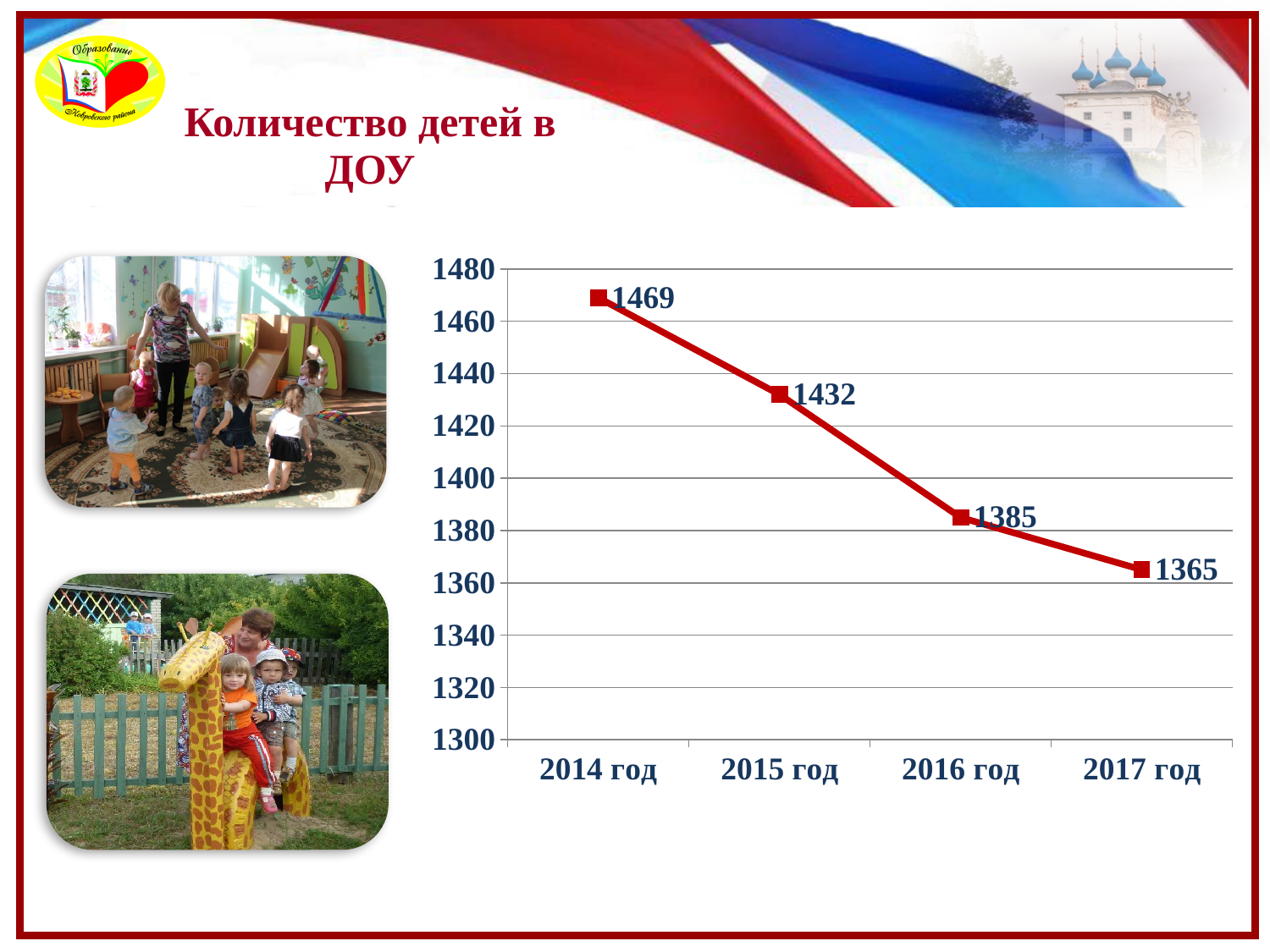
What is the number of children in 2014 год? 1469 What is the difference between the values for 2015 год and 2016 год? 47 What is the number of children in 2015 год? 1432 What is the number of children in 2016 год? 1385 What kind of chart is shown on the slide? line chart What is the difference between the values for 2014 год and 2017 год? 104 Which year has the lowest number of children? 2017 год Do the values rise or fall from 2014 год to 2017 год? fall Which year has the highest number of children? 2014 год Which is larger, the value for 2015 год or the value for 2016 год? 2015 год What is the number of children in 2017 год? 1365 How many years are plotted on the chart? 4